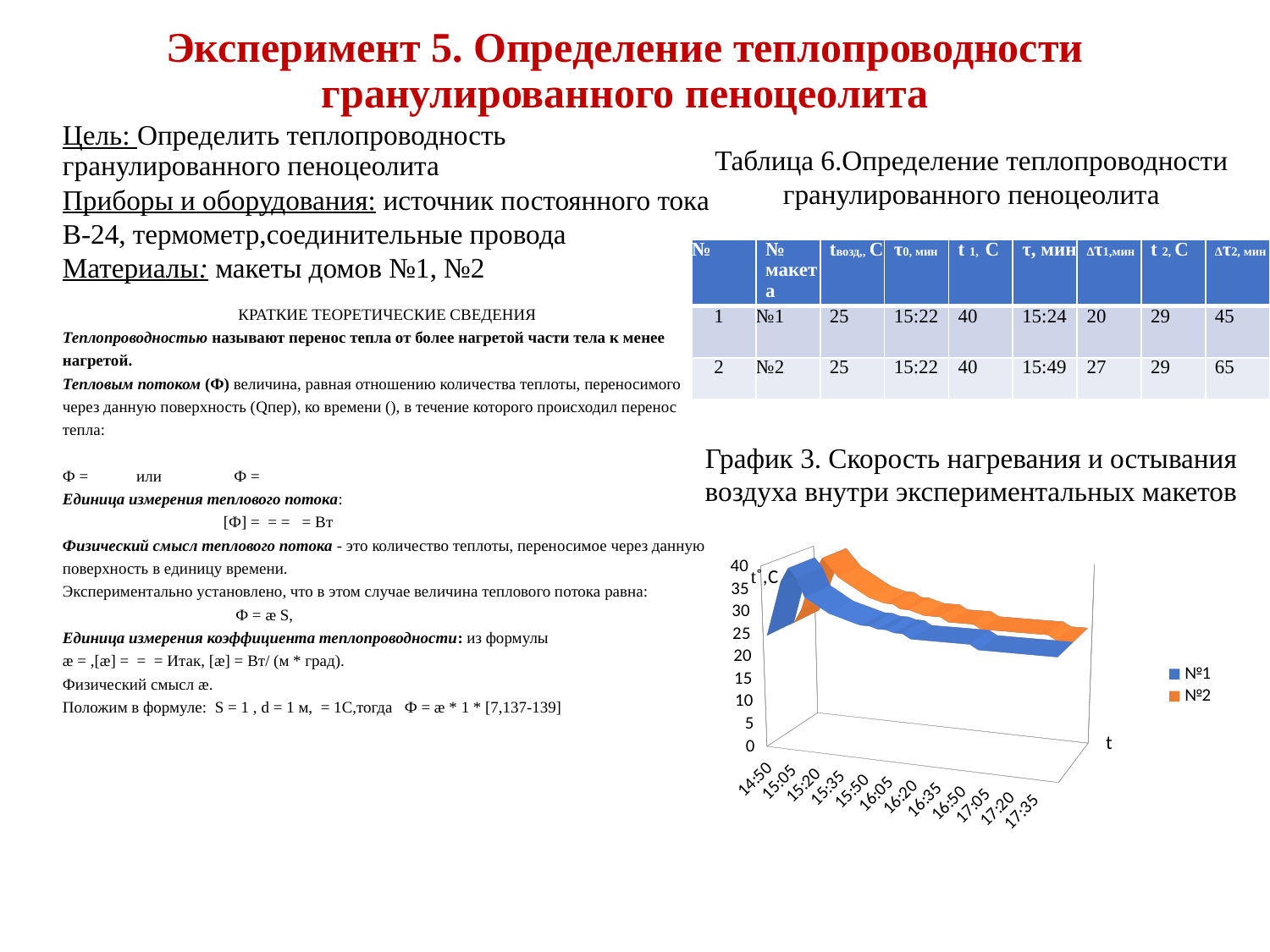
Is the highest value reached by series №1 greater or less than 30? greater How many series does the legend of the chart list? 2 What is the last time label on the x axis of the chart? 17:35 Is the value for series №1 at 17:35 greater or less than 35? less What are the names of the series in the chart legend? №1 and №2 What kind of chart is shown under 'График 3'? 3D line chart What is the first time label on the x axis of the chart? 14:50 What is the maximum value shown on the vertical axis of the chart? 40 After reaching their peak, do the values of series №1 rise or fall toward 17:35? fall How many time points are labelled along the x axis of the chart? 12